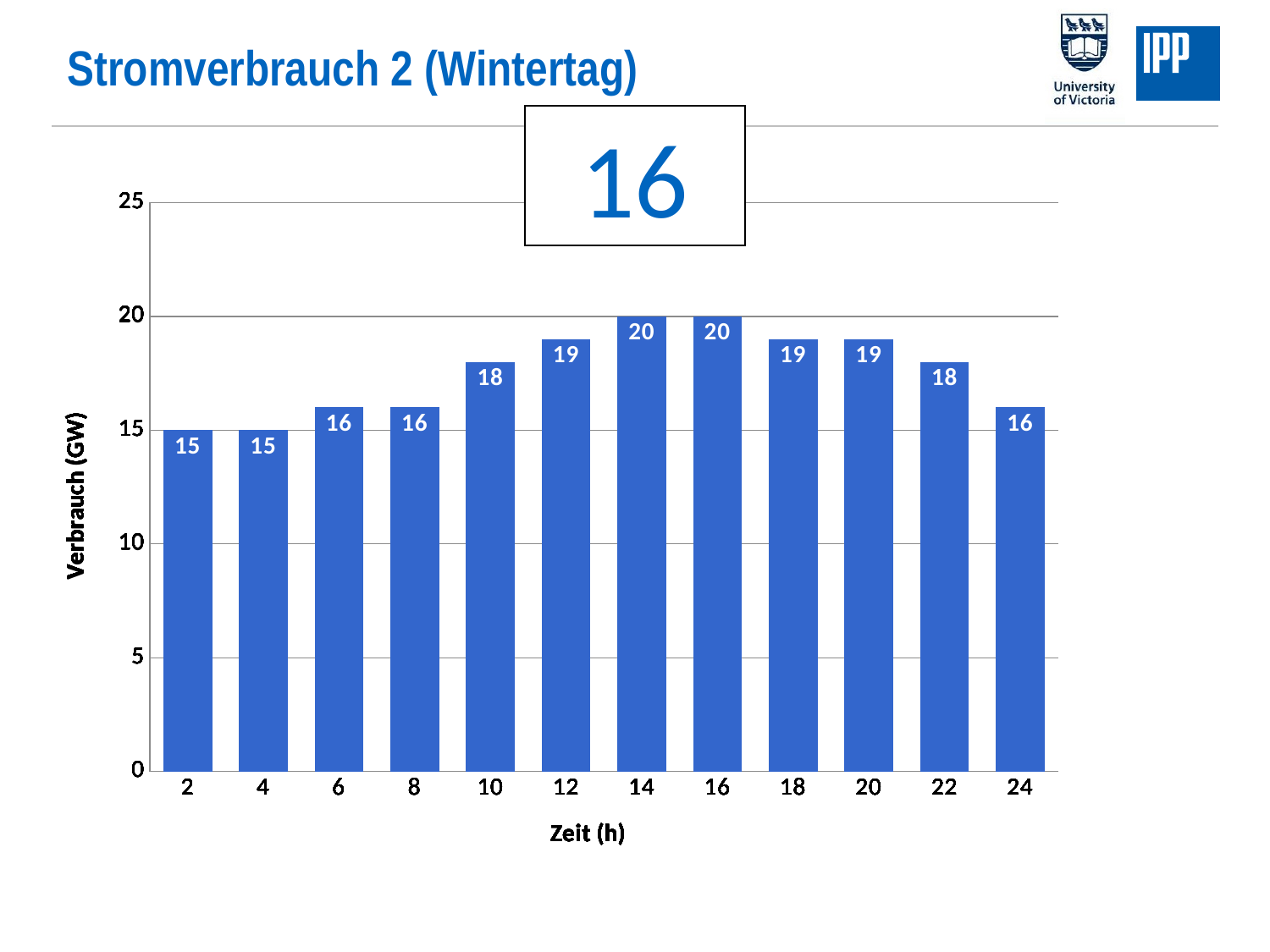
What is the label of the y axis? Verbrauch (GW) What is the highest value shown in the chart? 20 What is the value for Zeit 2 h? 15 What is the lowest value shown in the chart? 15 Which is larger, the value at 12 h or the value at 24 h? 12 h What kind of chart is shown on the slide? bar chart How many bars are shown in the chart? 12 Do the values rise or fall from 2 h to 14 h? rise Is the value for 16 h greater or less than 15? greater What is the value for Zeit 22 h? 18 What is the difference between the values at 14 h and 2 h? 5 What is the value for Zeit 10 h? 18